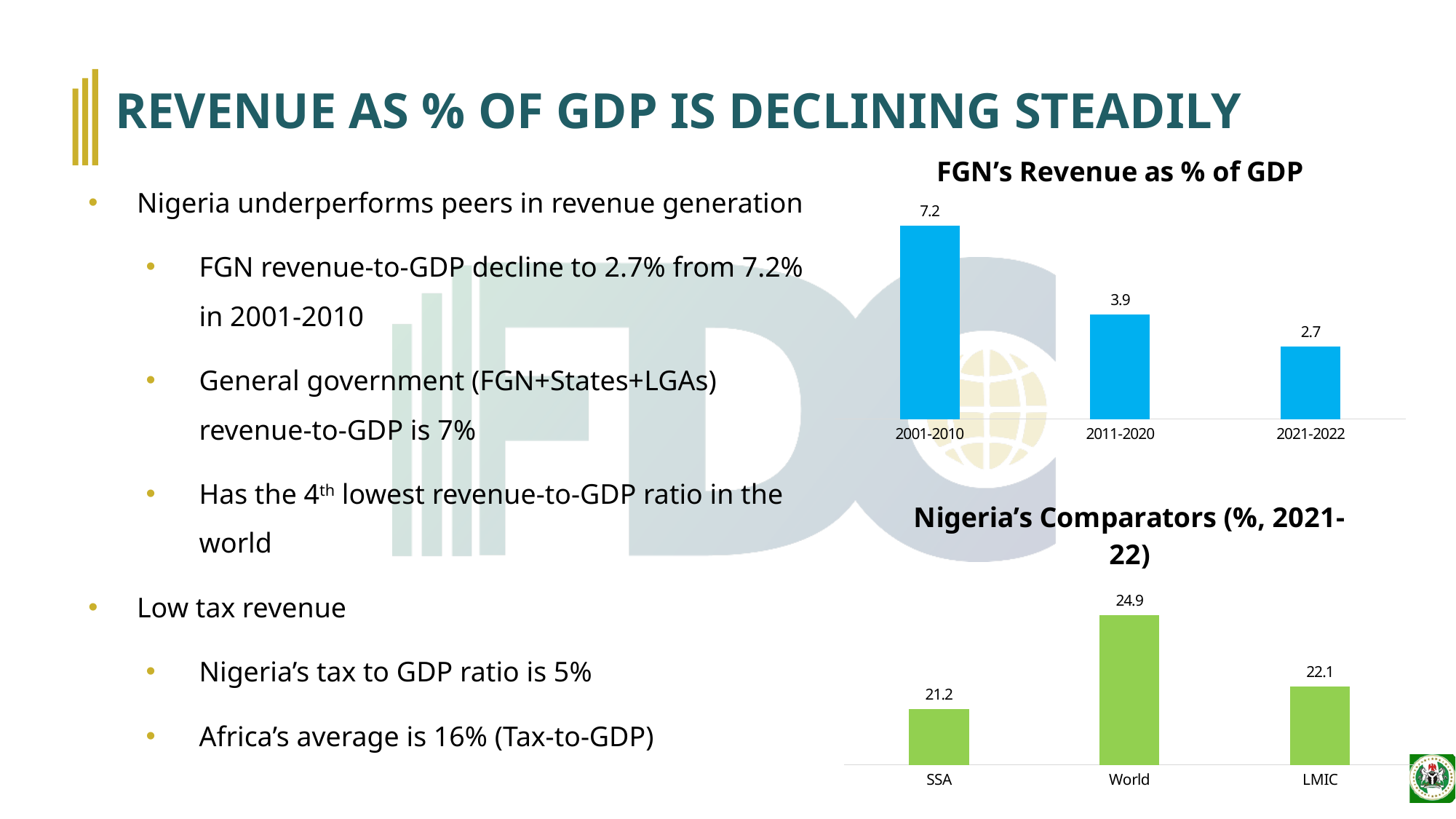
In the 'Nigeria's Comparators (%, 2021-22)' chart, what is the difference between World and SSA? 3.7 In the 'Nigeria's Comparators (%, 2021-22)' chart, which is larger, SSA or LMIC? LMIC In the 'Nigeria's Comparators (%, 2021-22)' chart, what is the value for LMIC? 22.1 How many bars are in the 'FGN's Revenue as % of GDP' chart? 3 In the 'FGN's Revenue as % of GDP' chart, do the values rise or fall from left to right? fall In the 'FGN's Revenue as % of GDP' chart, what is the difference between the 2001-2010 and 2021-2022 values? 4.5 In the 'FGN's Revenue as % of GDP' chart, which period has the lowest value? 2021-2022 In the 'Nigeria's Comparators (%, 2021-22)' chart, which category has the highest value? World What type of chart is the 'Nigeria's Comparators (%, 2021-22)' chart? bar chart In the 'FGN's Revenue as % of GDP' chart, what is the value for 2011-2020? 3.9 In the 'Nigeria's Comparators (%, 2021-22)' chart, what is the value for World? 24.9 In the 'FGN's Revenue as % of GDP' chart, what is the value for 2001-2010? 7.2